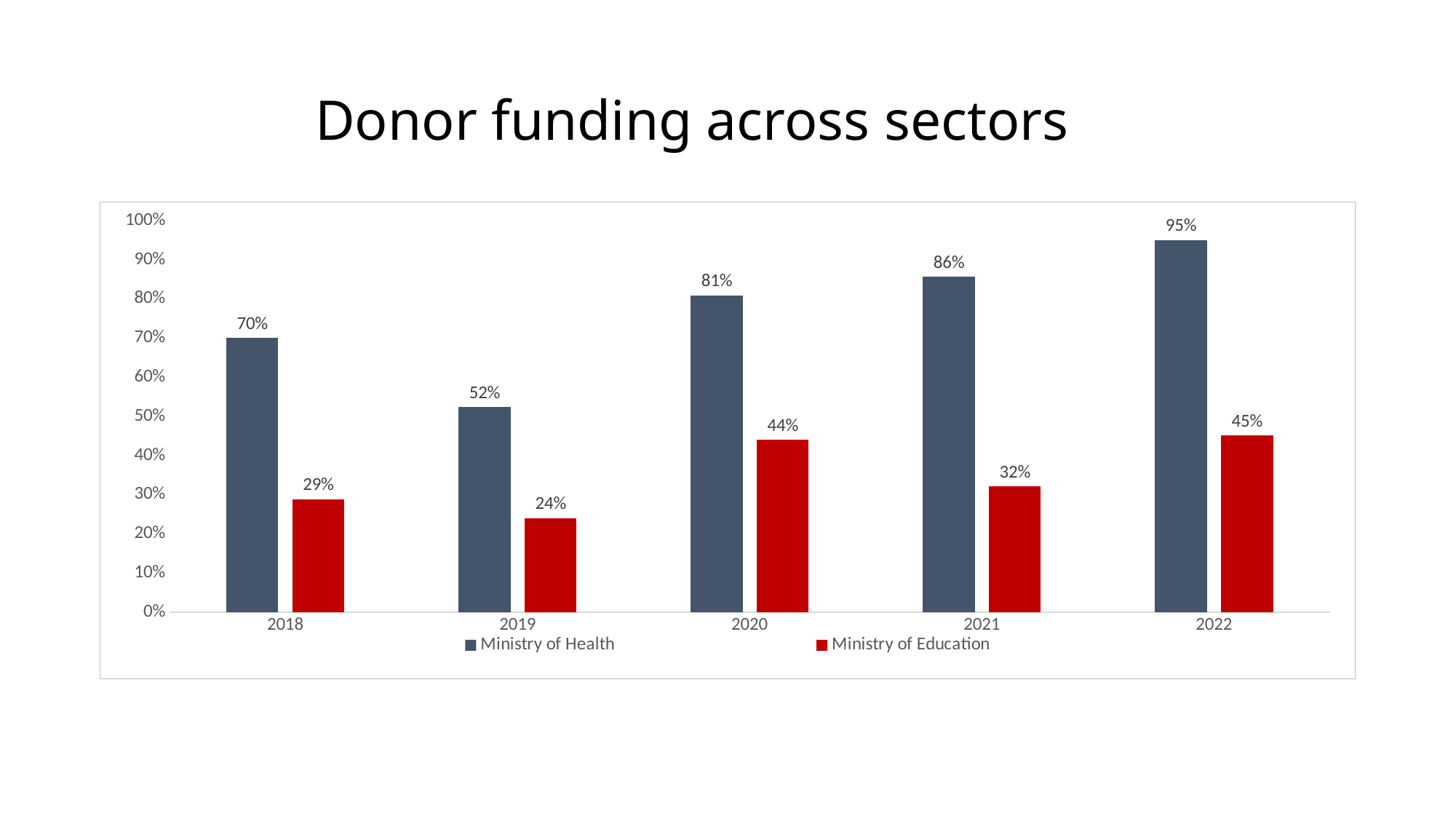
What kind of chart is shown on the slide? Bar chart What is the value for Ministry of Education in 2022? 45% What is the value for Ministry of Health in 2020? 81% What is the title of the chart? Donor funding across sectors Does the Ministry of Health value rise or fall from 2019 to 2022? Rise In which year is the Ministry of Education value lowest? 2019 What is the difference between the Ministry of Health and Ministry of Education values in 2021? 54% What is the value for Ministry of Education in 2019? 24% In which year is the Ministry of Health value highest? 2022 Which is larger: Ministry of Education in 2020 or Ministry of Education in 2021? Ministry of Education in 2020 How many series does the legend list? 2 How many years are shown on the x axis? 5